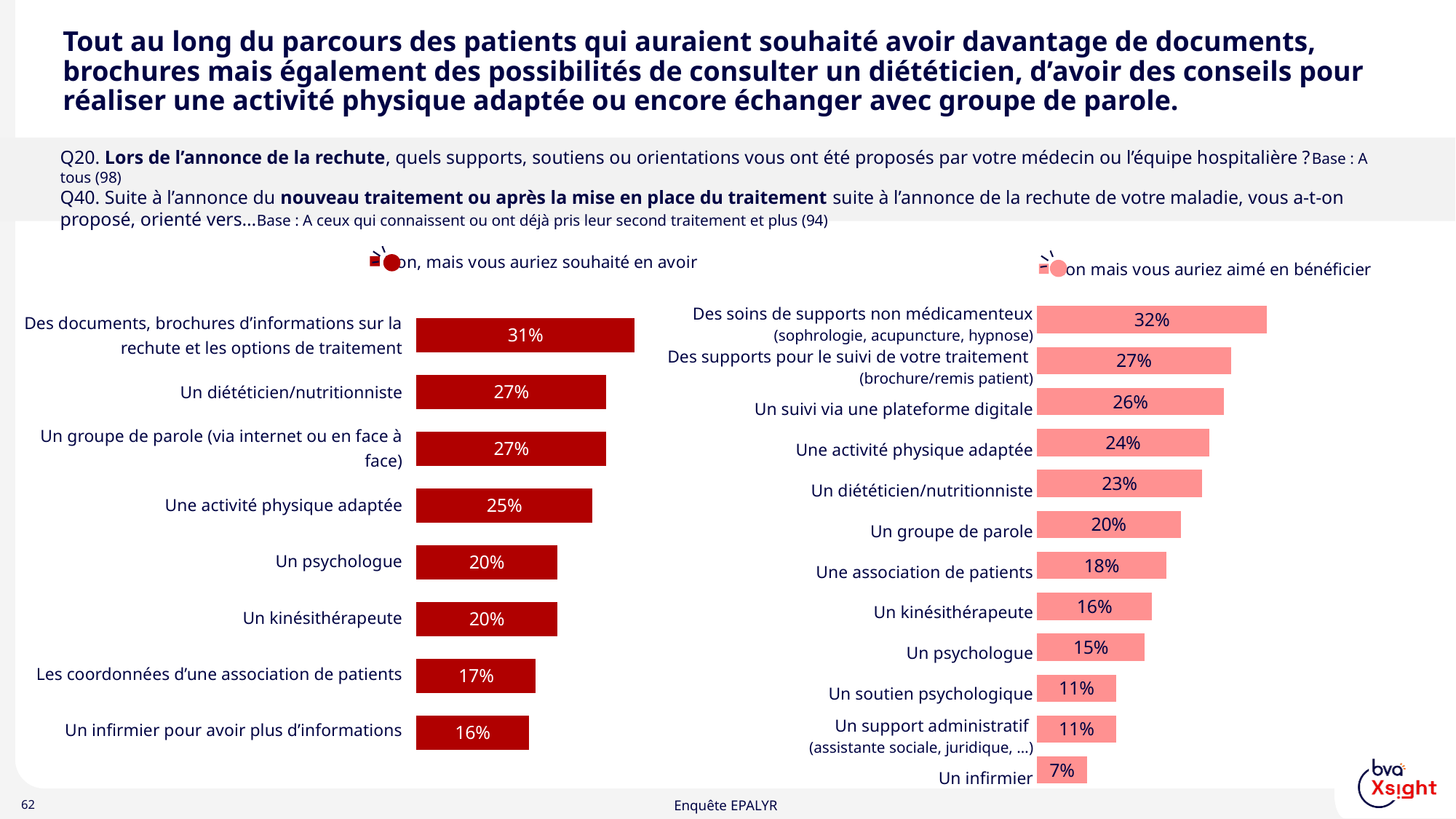
In the left chart, what is the value for 'Un diététicien/nutritionniste'? 27% In the right chart, do the values rise or fall from top to bottom? Fall How many categories are shown in the right chart? 12 In the left chart, which is larger: 'Une activité physique adaptée' or 'Un psychologue'? Une activité physique adaptée In the right chart, what is the value for 'Une association de patients'? 18% How many categories are shown in the left chart? 8 In the right chart, what is the value for 'Un suivi via une plateforme digitale'? 26% In the right chart, which category has the lowest value? Un infirmier In the left chart, which category has the highest value? Des documents, brochures d'informations sur la rechute et les options de traitement In the left chart, what is the value for 'Un infirmier pour avoir plus d'informations'? 16% In the right chart, what is the difference between 'Des soins de supports non médicamenteux' and 'Un infirmier'? 25 percentage points What type of chart is the left chart? Bar chart